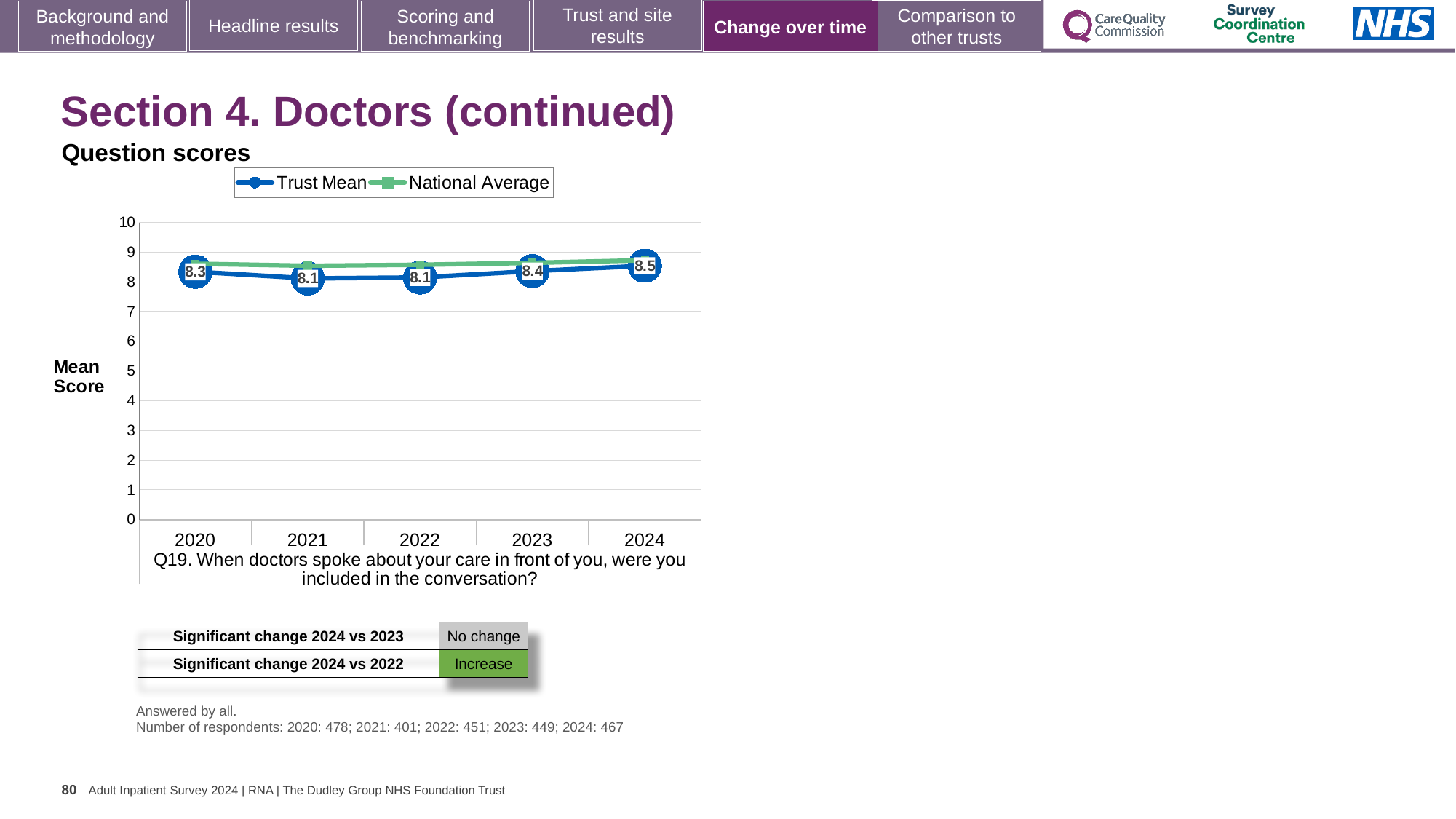
In which year is the Trust Mean score highest? 2024 What is the Trust Mean score for 2020? 8.3 What kind of chart is shown on the slide? Line chart What is the Trust Mean score for 2023? 8.4 How many years are plotted on the x axis? 5 In 2021, which series has the higher value, Trust Mean or National Average? National Average Is the National Average value for 2020 greater or less than 8? greater What is the difference between the Trust Mean scores for 2024 and 2021? 0.4 What is the Trust Mean score for 2024? 8.5 What is the lowest Trust Mean score shown on the chart? 8.1 Which year has the larger Trust Mean score, 2020 or 2021? 2020 How many series does the legend list? 2